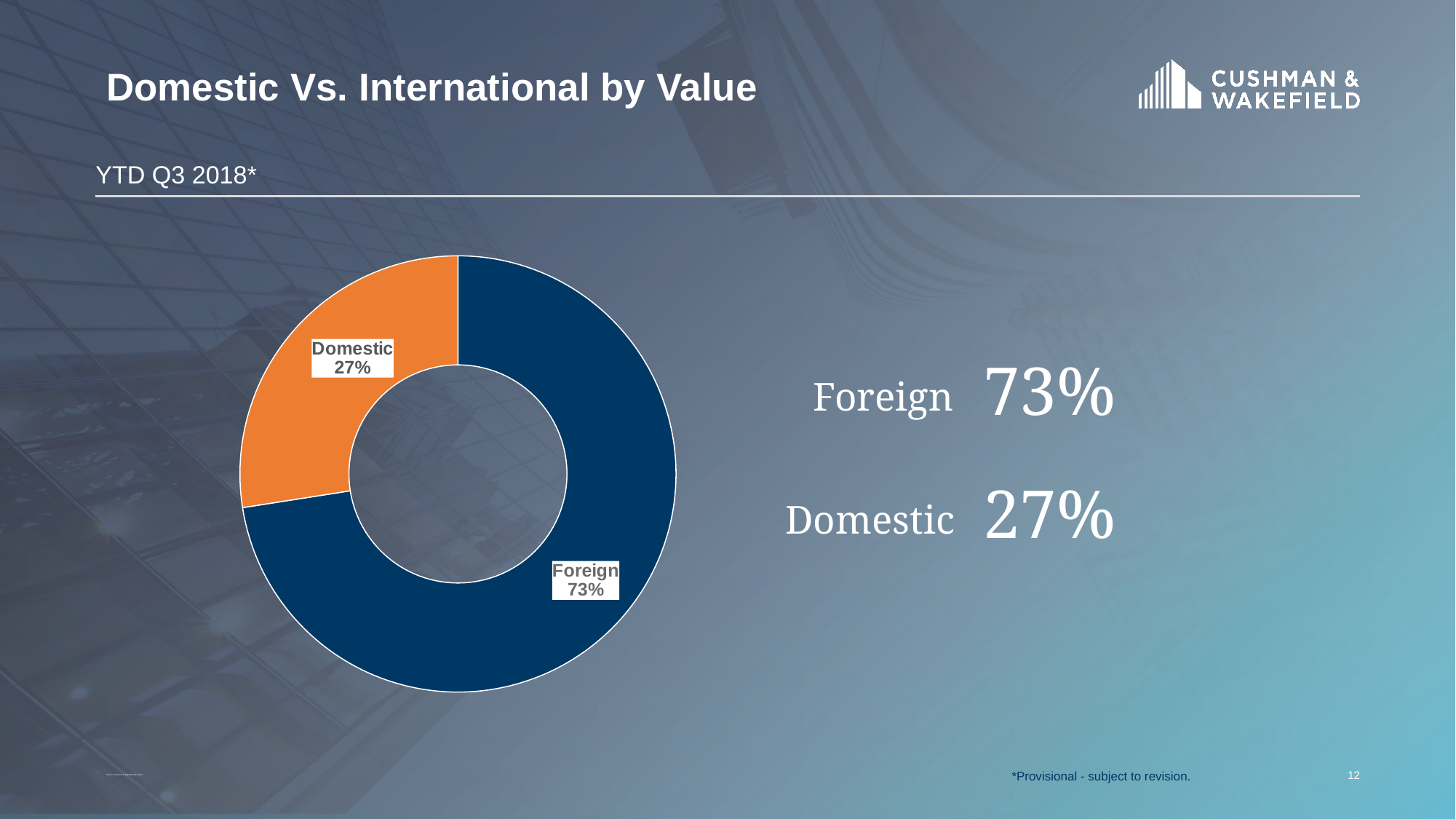
What share of the chart does the Foreign slice represent? 73% How many slices does the chart have? 2 What colour is the Domestic slice? Orange What kind of chart is shown on the slide? Doughnut chart What share of the chart does the Domestic slice represent? 27% What is the combined share of the Foreign and Domestic slices? 100% What is the difference in percentage points between the Foreign and Domestic shares? 46 Which is larger, the Domestic share or the Foreign share? Foreign Which category has the smallest share in the chart? Domestic What period does the chart cover, according to the subtitle? YTD Q3 2018* Which category has the largest share in the chart? Foreign